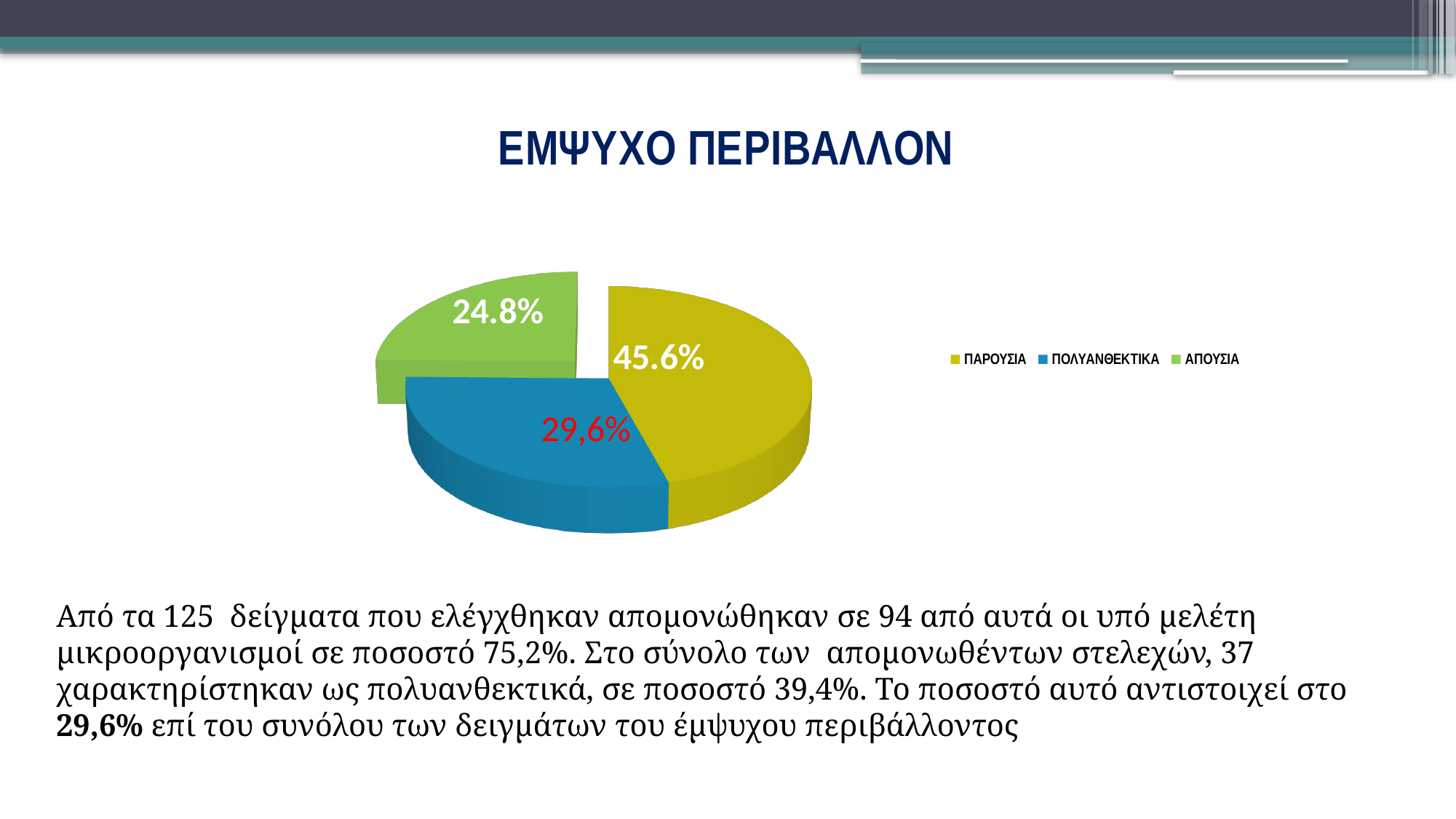
What percentage is shown for ΠΟΛΥΑΝΘΕΚΤΙΚΑ in the pie chart? 29,6% What is the title of the chart on the slide? ΕΜΨΥΧΟ ΠΕΡΙΒΑΛΛΟΝ By how many percentage points does the ΠΑΡΟΥΣΙΑ slice exceed the ΑΠΟΥΣΙΑ slice? 20.8 percentage points How many entries does the legend of the pie chart list? 3 Which colour represents ΠΟΛΥΑΝΘΕΚΤΙΚΑ in the pie chart? Blue What percentage is shown for ΑΠΟΥΣΙΑ in the pie chart? 24.8% What kind of chart is shown on the slide? Pie chart Which slice is larger in the pie chart, ΠΟΛΥΑΝΘΕΚΤΙΚΑ or ΑΠΟΥΣΙΑ? ΠΟΛΥΑΝΘΕΚΤΙΚΑ What percentage is shown for ΠΑΡΟΥΣΙΑ in the pie chart? 45.6% Which category has the smallest slice in the pie chart? ΑΠΟΥΣΙΑ Which category has the largest slice in the pie chart? ΠΑΡΟΥΣΙΑ How many slices does the pie chart have? 3